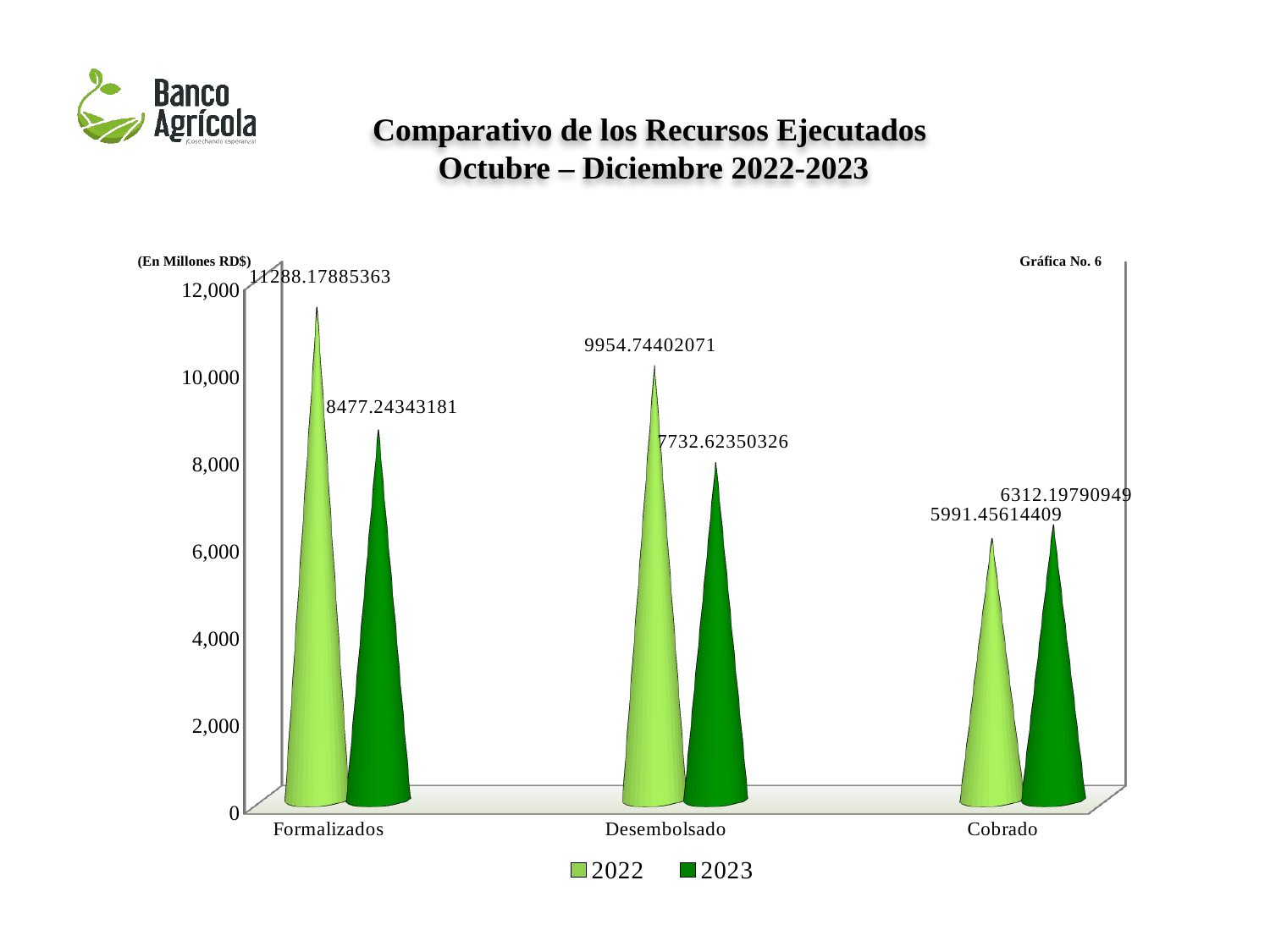
What is the value for Desembolsado in 2023? 7732.62350326 What is the value for Cobrado in 2023? 6312.19790949 How many series does the legend list? 2 What is the value for Cobrado in 2022? 5991.45614409 What is the value for Formalizados in 2022? 11288.17885363 Which category has the lowest value for 2023? Cobrado What kind of chart is shown on the slide? Bar chart How many categories are shown on the x axis? 3 Which category has the highest value for 2022? Formalizados What is the difference between the 2022 and 2023 values for Formalizados? 2810.93542182 What is the difference between the 2022 and 2023 values for Desembolsado? 2222.12051745 For Cobrado, which year has the larger value, 2022 or 2023? 2023